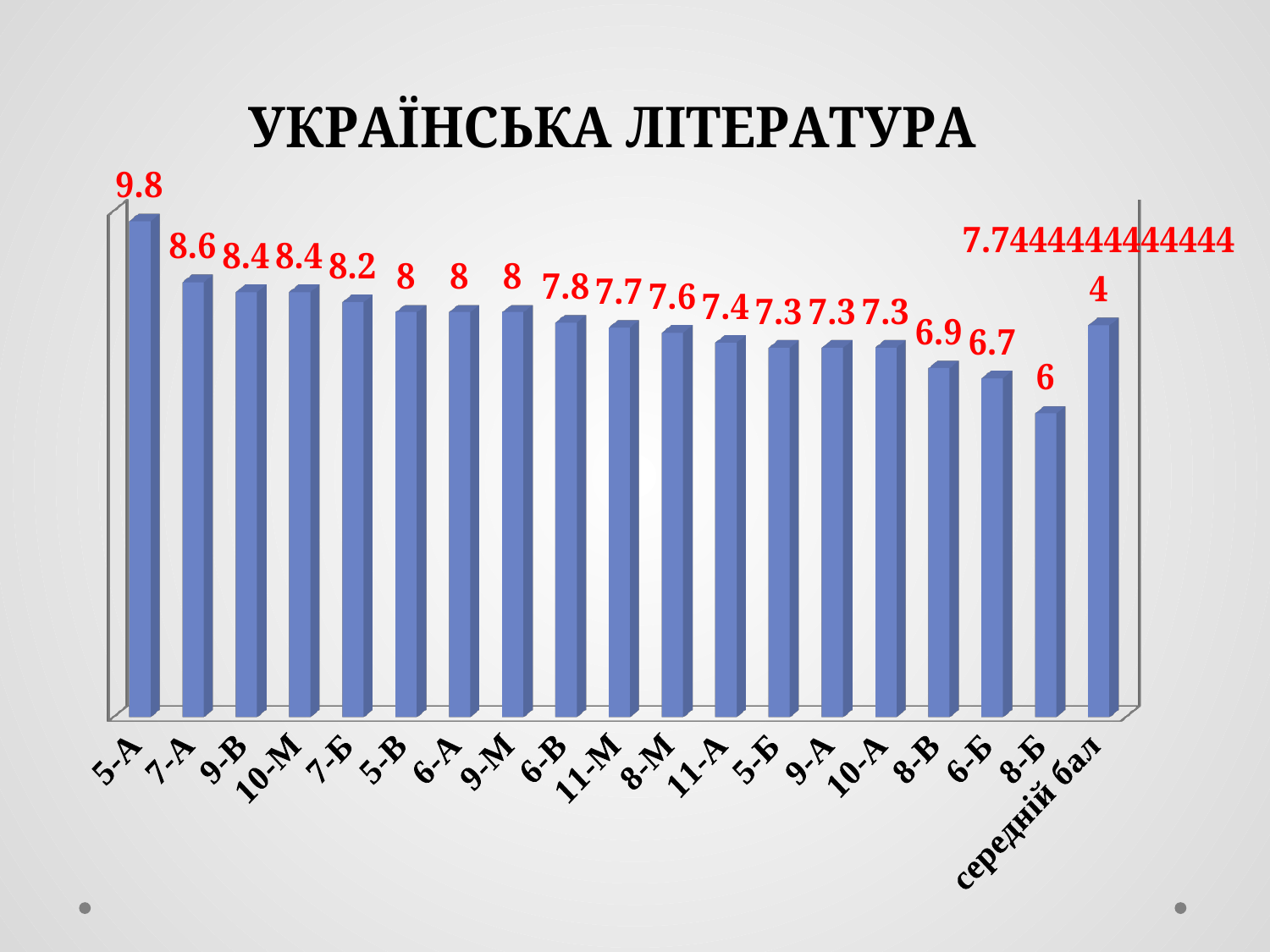
Which is larger, the value for 8-В or the value for середній бал? середній бал How many bars are shown in the chart? 19 What is the value for 6-Б? 6.7 Which class has the lowest value? 8-Б Which is larger, the value for 7-А or the value for 7-Б? 7-А What is the value for 5-А? 9.8 What kind of chart is this? bar chart What is the title of the chart? УКРАЇНСЬКА ЛІТЕРАТУРА What is the value for 8-Б? 6 What is the difference between the values for 7-А and 6-Б? 1.9 What is the difference between the values for 5-А and 8-Б? 3.8 Which class has the highest value? 5-А